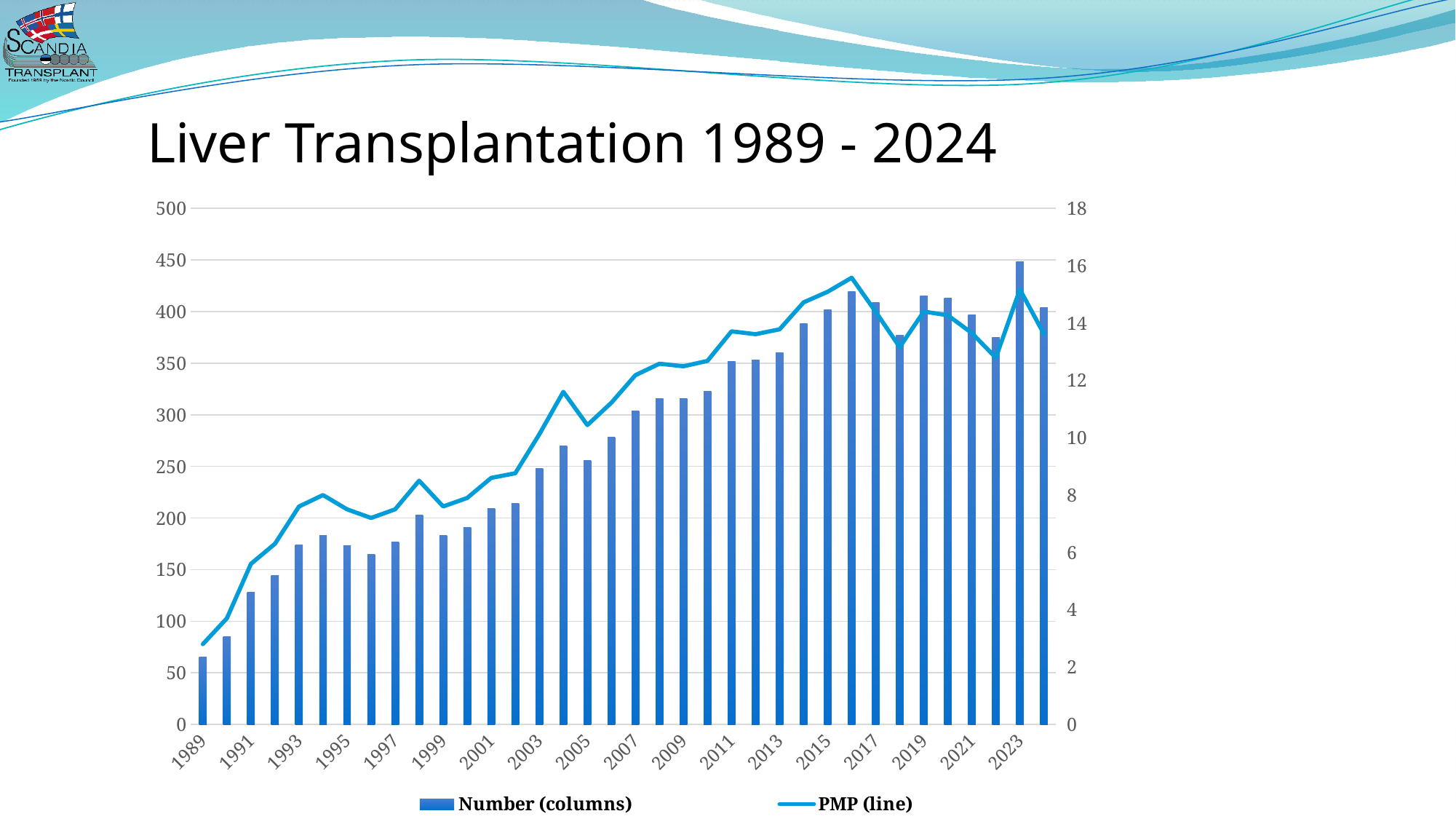
What are the two series named in the legend? Number (columns) and PMP (line) Which year has the larger Number value, 2023 or 2024? 2023 Which year has the lowest bar for Number? 1989 Which year has the highest bar for Number? 2023 What kind of chart is shown on the slide? A combined bar and line chart Is the Number value for 2023 greater or less than 400? greater What is the title of the chart? Liver Transplantation 1989 - 2024 How many years (bars) are plotted on the x axis? 36 Is the Number value for 2009 greater or less than 300? greater Overall, do the Number values rise or fall from 1989 to 2024? rise How many series does the legend list? 2 Is the Number value for 1989 greater or less than 100? less